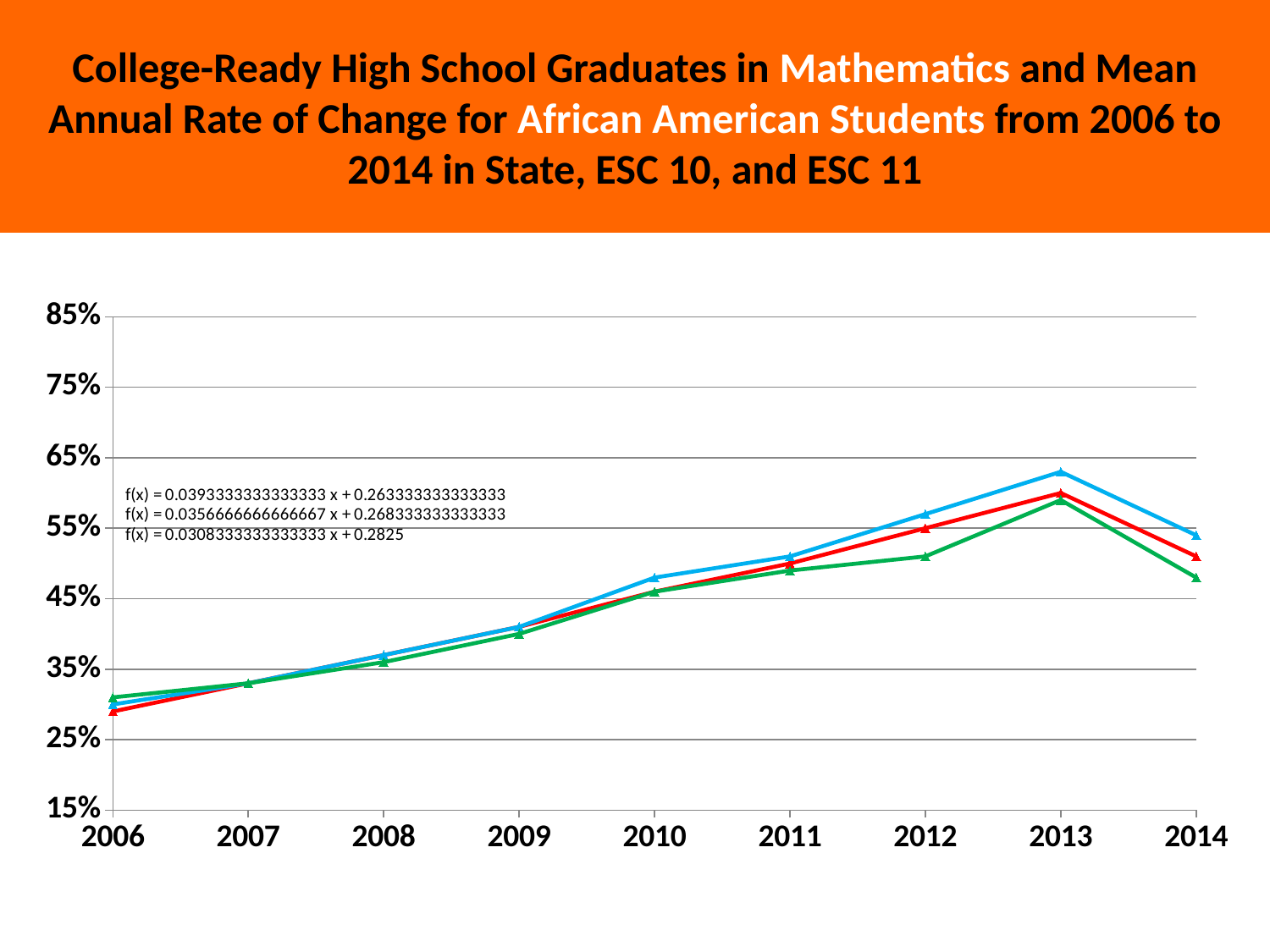
How many lines are plotted on the chart? 3 In 2013, which line has the higher value, the blue line or the green line? the blue line In which year does the blue line reach its highest value? 2013 What kind of chart is shown on the slide? line chart In which year does the blue line have its lowest value? 2006 What is the first trendline equation printed on the chart? f(x) = 0.0393333333333333 x + 0.263333333333333 Do the values of the blue line rise or fall from 2006 to 2013? rise Is the value of the blue line in 2013 greater or less than 55%? greater Is the value of the red line in 2006 greater or less than 35%? less How many years are plotted along the x axis of the chart? 9 Is the value of the green line in 2014 greater or less than 55%? less